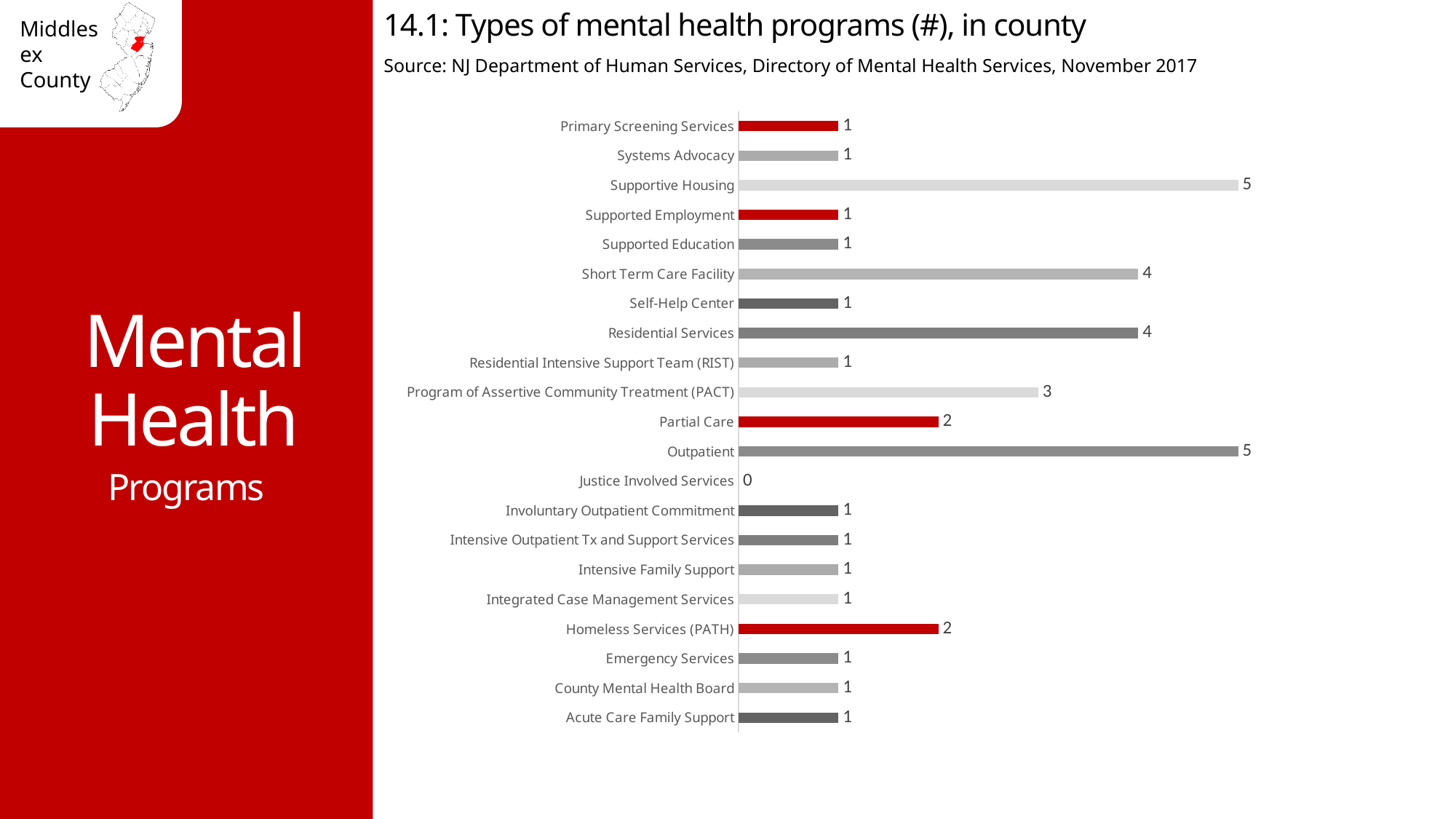
What is the value for Justice Involved Services? 0 Which is larger, the value for Residential Services or the value for Self-Help Center? Residential Services What is the value for Program of Assertive Community Treatment (PACT)? 3 What is the highest value shown in the chart? 5 What is the title of the chart? 14.1: Types of mental health programs (#), in county How many categories are shown in the chart? 21 What kind of chart is shown on the slide? Bar chart What is the value for Homeless Services (PATH)? 2 What is the value for Short Term Care Facility? 4 Which category has the lowest value? Justice Involved Services What is the difference between the values for Outpatient and Partial Care? 3 What is the value for Supportive Housing? 5